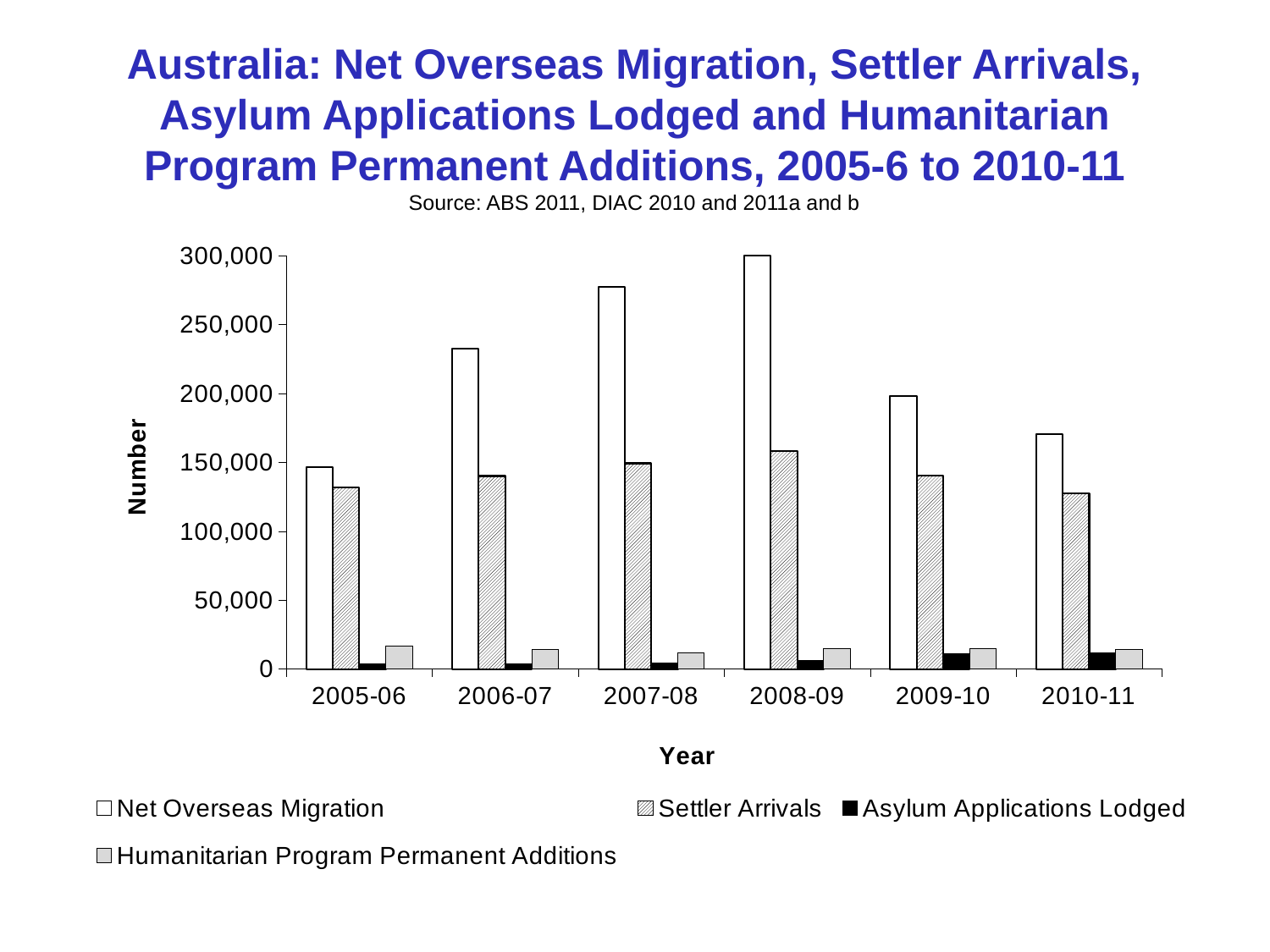
In which year is Net Overseas Migration highest? 2008-09 What kind of chart is shown on the slide? Bar chart Does Net Overseas Migration rise or fall from 2008-09 to 2010-11? Fall Is the value for Humanitarian Program Permanent Additions in 2005-06 greater or less than 50,000? less Is the value for Net Overseas Migration in 2008-09 greater or less than 250,000? greater What is the label on the y axis? Number Which is larger: Net Overseas Migration in 2007-08 or in 2009-10? 2007-08 How many years are shown on the x axis? 6 Is the value for Net Overseas Migration in 2006-07 greater or less than 200,000? greater How many series does the legend list? 4 In which year are Settler Arrivals highest? 2008-09 In which year is Net Overseas Migration lowest? 2005-06